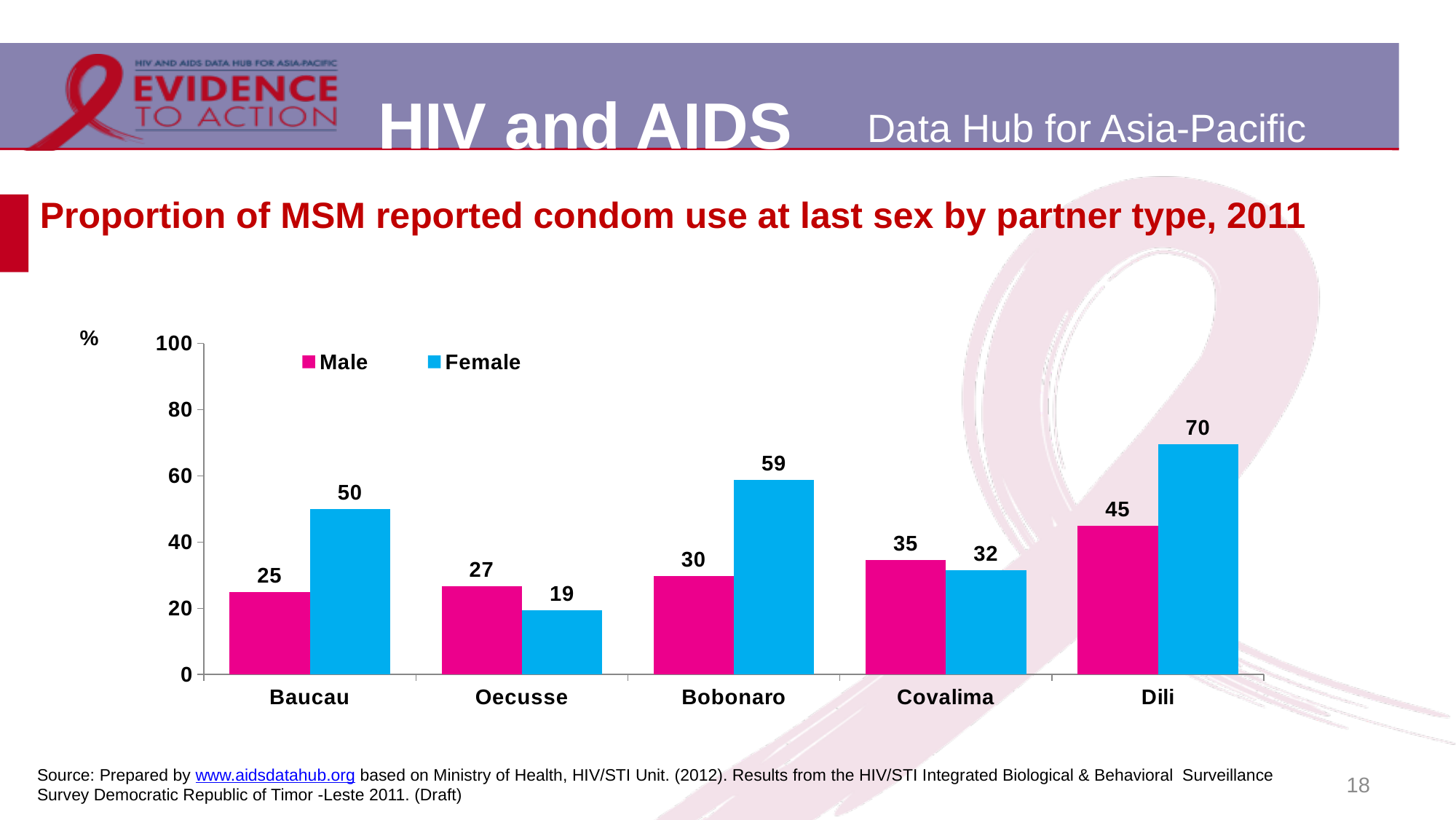
What colour represents the Female series? blue How many series does the legend list? 2 Which district has the highest Female value? Dili What is the Female value for Oecusse? 19 What is the Female value for Dili? 70 Is the Female value for Dili greater or less than 60? greater How many districts are shown on the x axis? 5 What is the difference between the Female and Male values for Bobonaro? 29 Which district has the lowest Male value? Baucau What kind of chart is shown on the slide? bar chart For Covalima, which is larger, the Male value or the Female value? Male What is the Male value for Baucau? 25